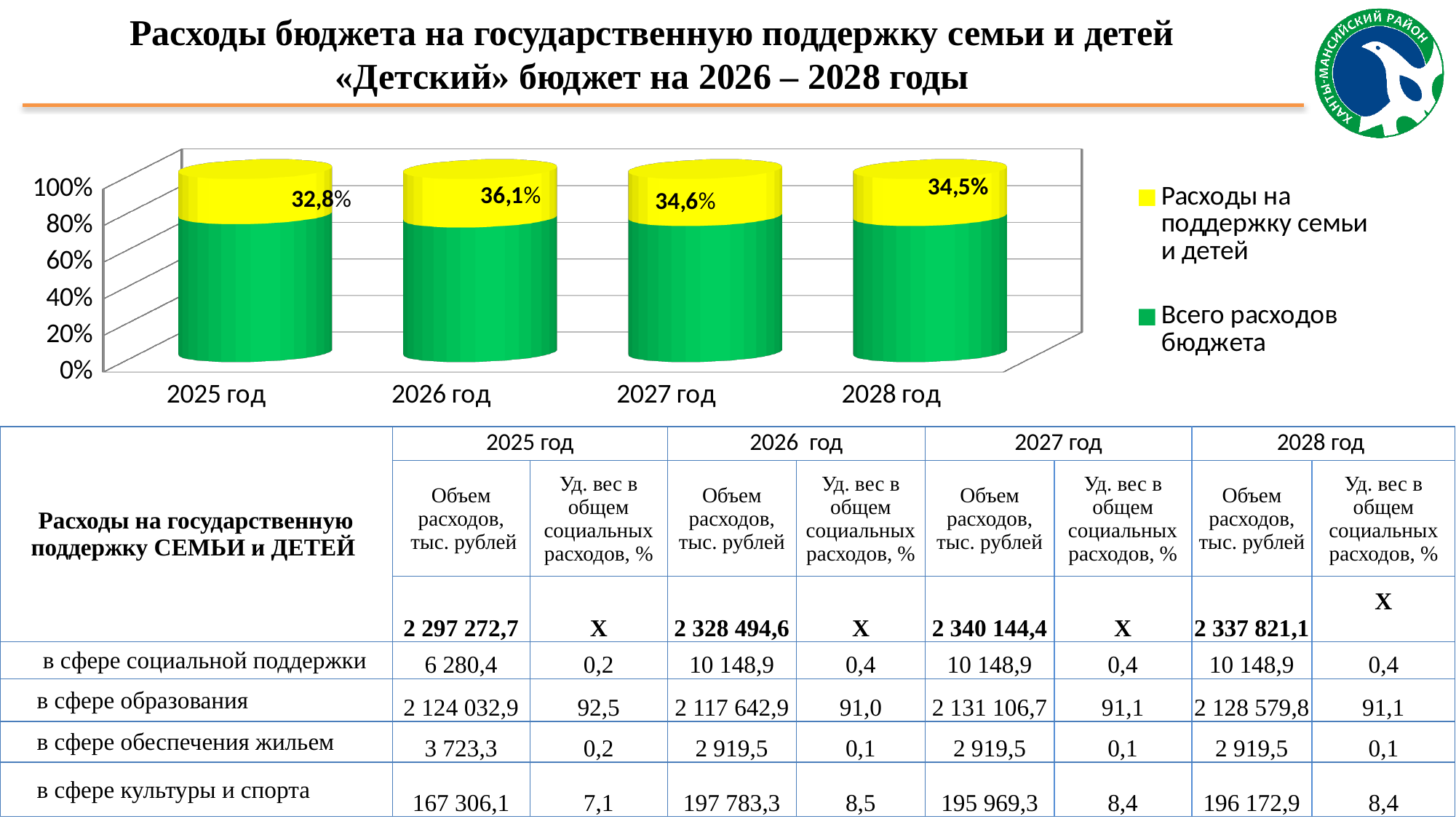
What value is labelled on the yellow segment (Расходы на поддержку семьи и детей) for 2025 год? 32,8% What value is labelled on the yellow segment for 2028 год? 34,5% How many years (categories) are shown on the x axis of the chart? 4 What value is labelled on the yellow segment for 2026 год? 36,1% Which year has a larger labelled share: 2027 год or 2028 год? 2027 год In which year is the labelled share for Расходы на поддержку семьи и детей the lowest? 2025 год What is the difference between the labelled shares for 2026 год and 2025 год? 3,3 percentage points What value is labelled on the yellow segment for 2027 год? 34,6% What kind of chart is shown on the slide? Stacked bar chart How many series does the chart legend list? 2 Which legend entry is shown in green? Всего расходов бюджета In which year is the labelled share for Расходы на поддержку семьи и детей the highest? 2026 год